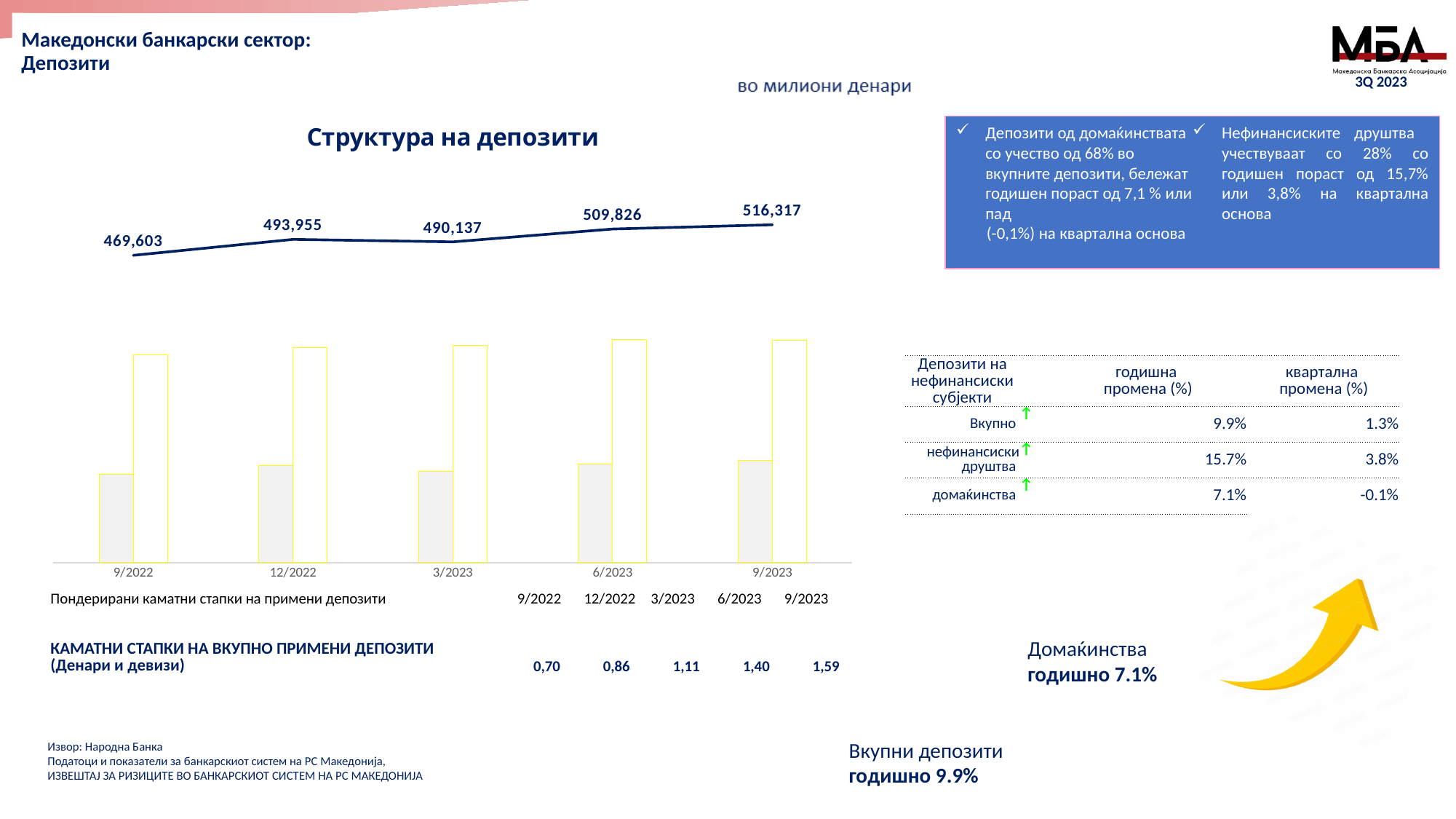
How many periods are plotted in the 'Структура на депозити' line chart? 5 In the 'Структура на депозити' line chart, what is the difference between the values for 9/2023 and 9/2022? 46,714 In the 'Структура на депозити' line chart, what is the value for 3/2023? 490,137 In the 'Структура на депозити' line chart, which period has the lowest value? 9/2022 In the 'Структура на депозити' line chart, which period has the highest value? 9/2023 In the 'Структура на депозити' line chart, which is larger: the value for 12/2022 or the value for 3/2023? 12/2022 What kind of chart is the lower chart on the left of the slide, with periods 9/2022 to 9/2023? bar chart In the 'Структура на депозити' line chart, what is the value for 12/2022? 493,955 What kind of chart is the 'Структура на депозити' chart at the top of the slide? line chart In the 'Структура на депозити' line chart, what is the value for 9/2022? 469,603 In the 'Структура на депозити' line chart, what is the value for 9/2023? 516,317 In the lower bar chart on the left, for 9/2023, which bar is taller: the grey bar or the white bar? the white bar